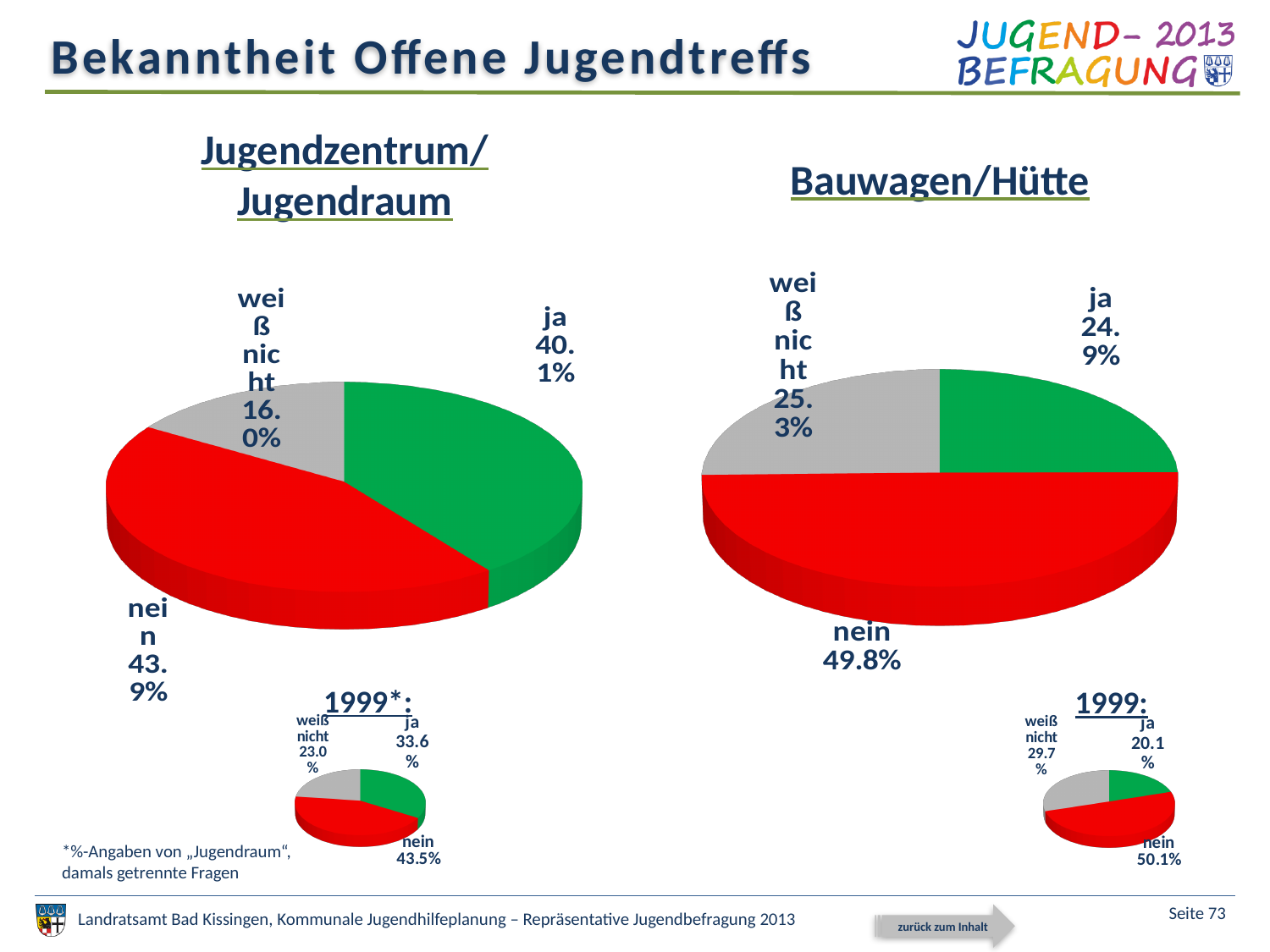
In the large Jugendzentrum/Jugendraum pie chart, what is the value for "ja"? 40.1% In the large Bauwagen/Hütte pie chart, what is the value for "nein"? 49.8% In the large Bauwagen/Hütte pie chart, which category has the largest share? nein In the large Jugendzentrum/Jugendraum pie chart, which category has the smallest share? weiß nicht In the small 1999* pie chart under Jugendzentrum/Jugendraum, what is the value for "ja"? 33.6% In the small 1999 pie chart under Bauwagen/Hütte, what is the value for "weiß nicht"? 29.7% In the large Bauwagen/Hütte pie chart, what colour is the "nein" slice? Red In the large Jugendzentrum/Jugendraum pie chart, what is the value for "weiß nicht"? 16.0% What type of chart is used for Jugendzentrum/Jugendraum? Pie chart In the large Jugendzentrum/Jugendraum pie chart, which is larger, "ja" or "nein"? nein In the large Bauwagen/Hütte pie chart, what is the difference between "nein" and "ja"? 24.9% How many categories does the large Bauwagen/Hütte pie chart show? 3